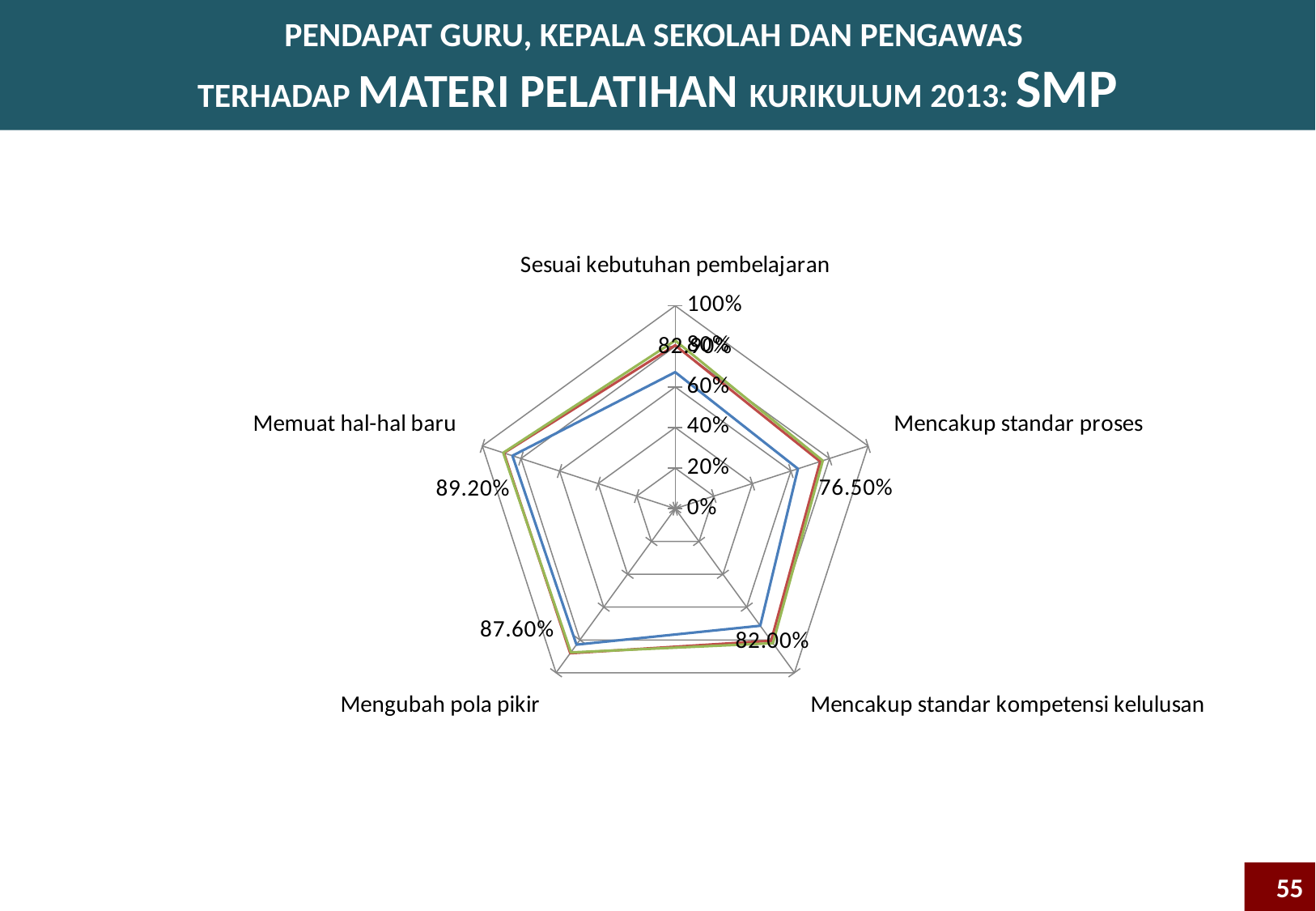
How many data series (lines) are plotted on the radar chart? 3 Which labelled value is larger: 'Mengubah pola pikir' or 'Mencakup standar kompetensi kelulusan'? Mengubah pola pikir What is the maximum value shown on the radar chart's axis scale? 100% What value is labelled for 'Mencakup standar kompetensi kelulusan'? 82.00% What value is labelled for 'Memuat hal-hal baru'? 89.20% What value is labelled for 'Mengubah pola pikir'? 87.60% How many categories (axes) does the radar chart have? 5 What kind of chart is shown on the slide? Radar chart Among the labelled values, which category has the highest value? Memuat hal-hal baru What is the difference between the labelled values for 'Memuat hal-hal baru' and 'Mencakup standar proses'? 12.70% What value is labelled for 'Mencakup standar proses'? 76.50% Among the labelled values, which category has the lowest value? Mencakup standar proses